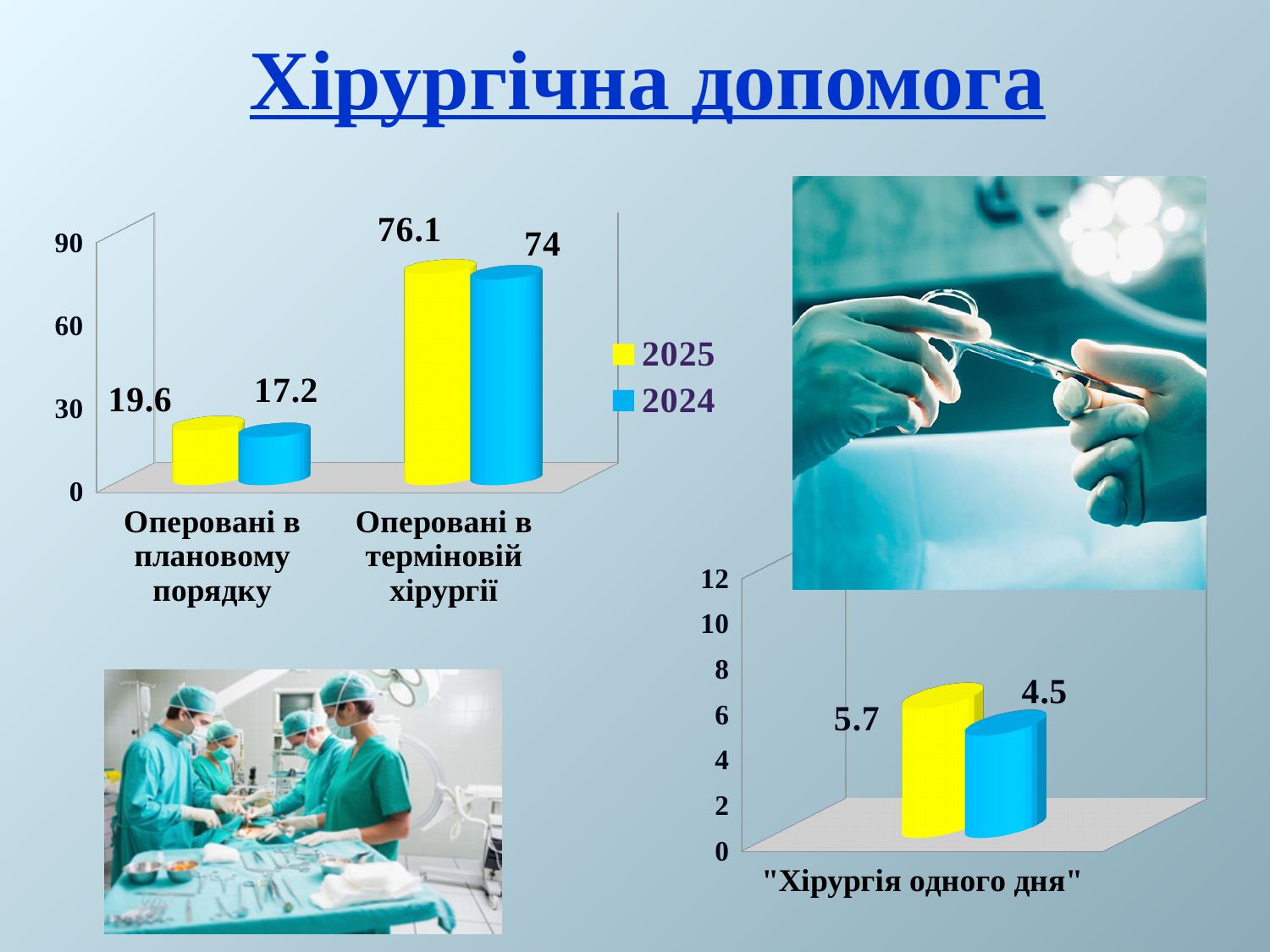
In the bottom-right chart "Хірургія одного дня", what is the value of the yellow bar? 5.7 In the left chart, which is larger for "Оперовані в терміновій хірургії": the 2025 value or the 2024 value? 2025 In the bottom-right chart "Хірургія одного дня", what is the difference between the yellow bar and the blue bar? 1.2 In the left chart, what is the 2024 value for "Оперовані в плановому порядку"? 17.2 How many series does the legend of the left chart list? 2 In the left chart, which category has the highest 2025 value? Оперовані в терміновій хірургії In the left chart, which colour represents 2025 in the legend? Yellow In the left chart, what is the 2025 value for "Оперовані в плановому порядку"? 19.6 In the left chart, what is the 2024 value for "Оперовані в терміновій хірургії"? 74 In the left chart, what is the difference between the 2025 and 2024 values for "Оперовані в плановому порядку"? 2.4 What kind of chart is the left chart? Bar chart How many categories are shown on the x axis of the left chart? 2